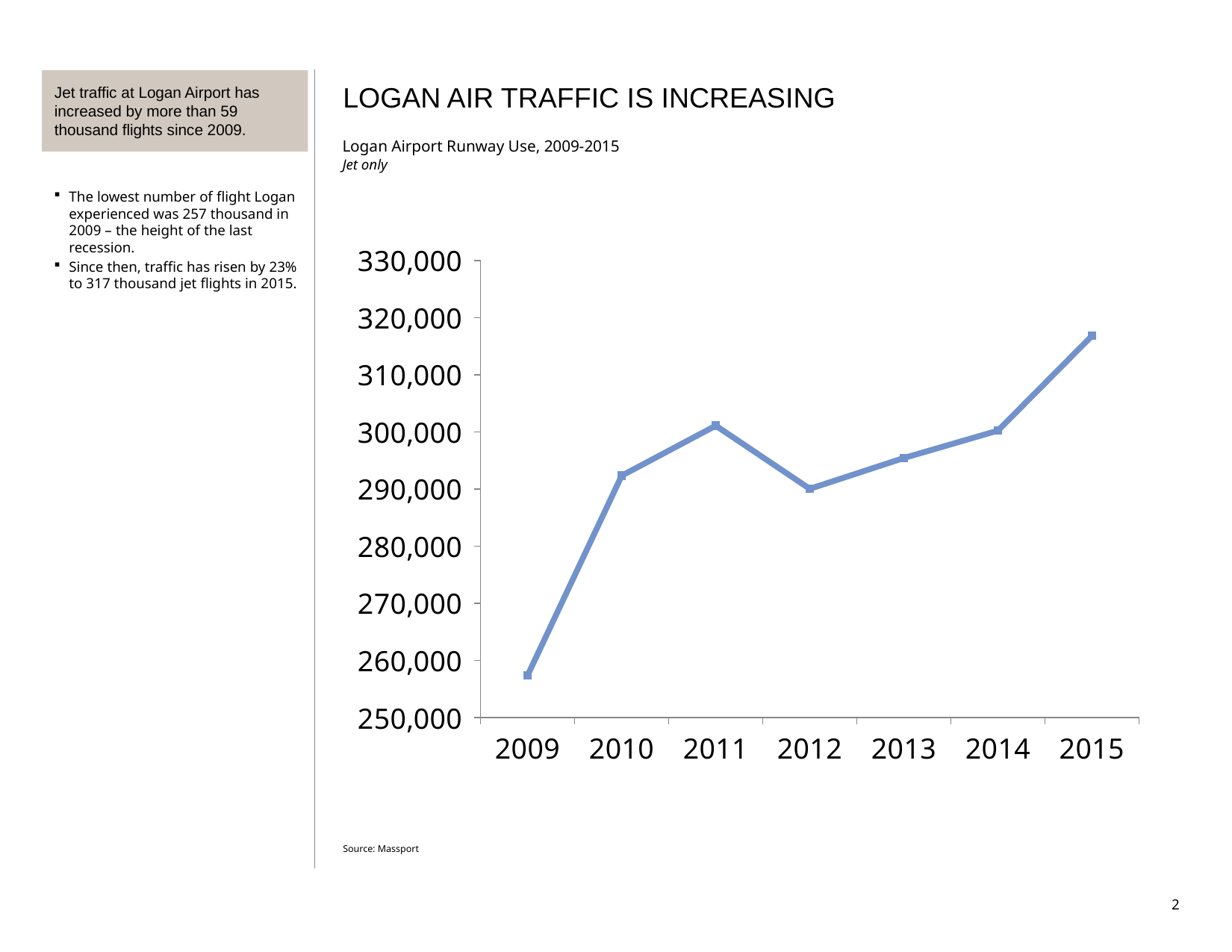
Which year has the larger value, 2009 or 2010? 2010 Is the value for 2015 greater or less than 310,000? greater Is the value for 2009 greater or less than 260,000? less Overall, do the values rise or fall from 2009 to 2015? rise What is the source cited below the chart? Massport Which year has the lowest number of jet flights in the chart? 2009 Which year has the larger value, 2011 or 2012? 2011 Is the value for 2013 greater or less than 300,000? less What kind of chart is shown on the slide? line chart How many years are plotted on the x axis of the chart? 7 Which year has the highest number of jet flights in the chart? 2015